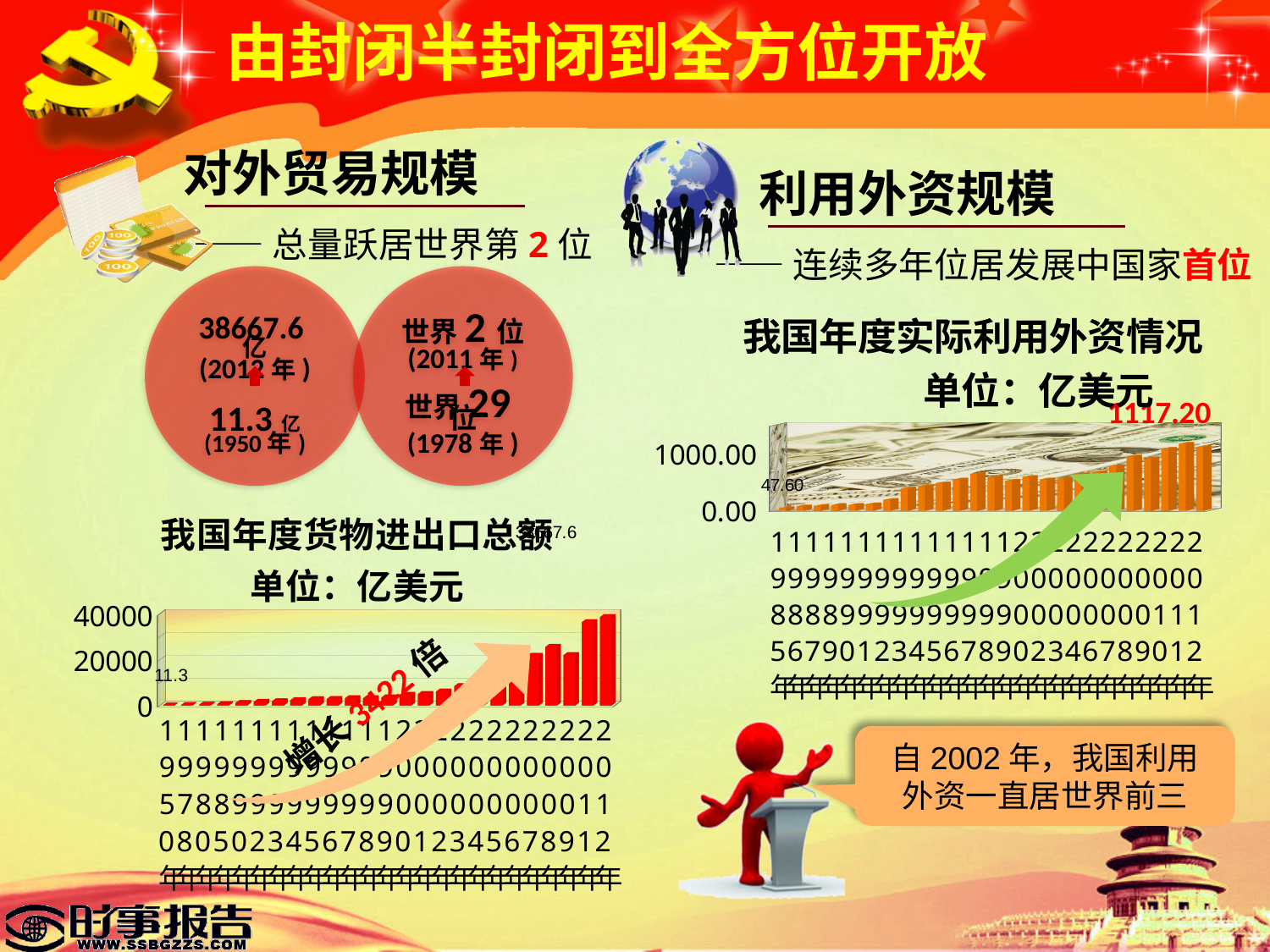
What colour are the bars in the chart titled 我国年度货物进出口总额? red In the chart titled 我国年度实际利用外资情况, what value is labelled on the rightmost (tallest) bar? 1117.20 What unit is stated under the title of the chart 我国年度实际利用外资情况? 亿美元 In the chart titled 我国年度实际利用外资情况, is the value of the rightmost bar greater or less than 1000.00? greater In the chart titled 我国年度实际利用外资情况, which bar is taller, the leftmost or the rightmost? the rightmost In the chart titled 我国年度货物进出口总额, what value is labelled on the leftmost bar? 11.3 What kind of chart is the chart titled 我国年度实际利用外资情况? bar chart In the chart titled 我国年度货物进出口总额, do the bar values generally rise or fall from left to right along the x axis? rise In the chart titled 我国年度实际利用外资情况, what is the difference between the labelled values of the rightmost bar and the leftmost bar? 1069.60 What kind of chart is the chart titled 我国年度货物进出口总额? bar chart In the chart titled 我国年度货物进出口总额, is the value of the rightmost bar greater or less than 20000? greater In the chart titled 我国年度实际利用外资情况, what value is labelled on the leftmost bar? 47.60